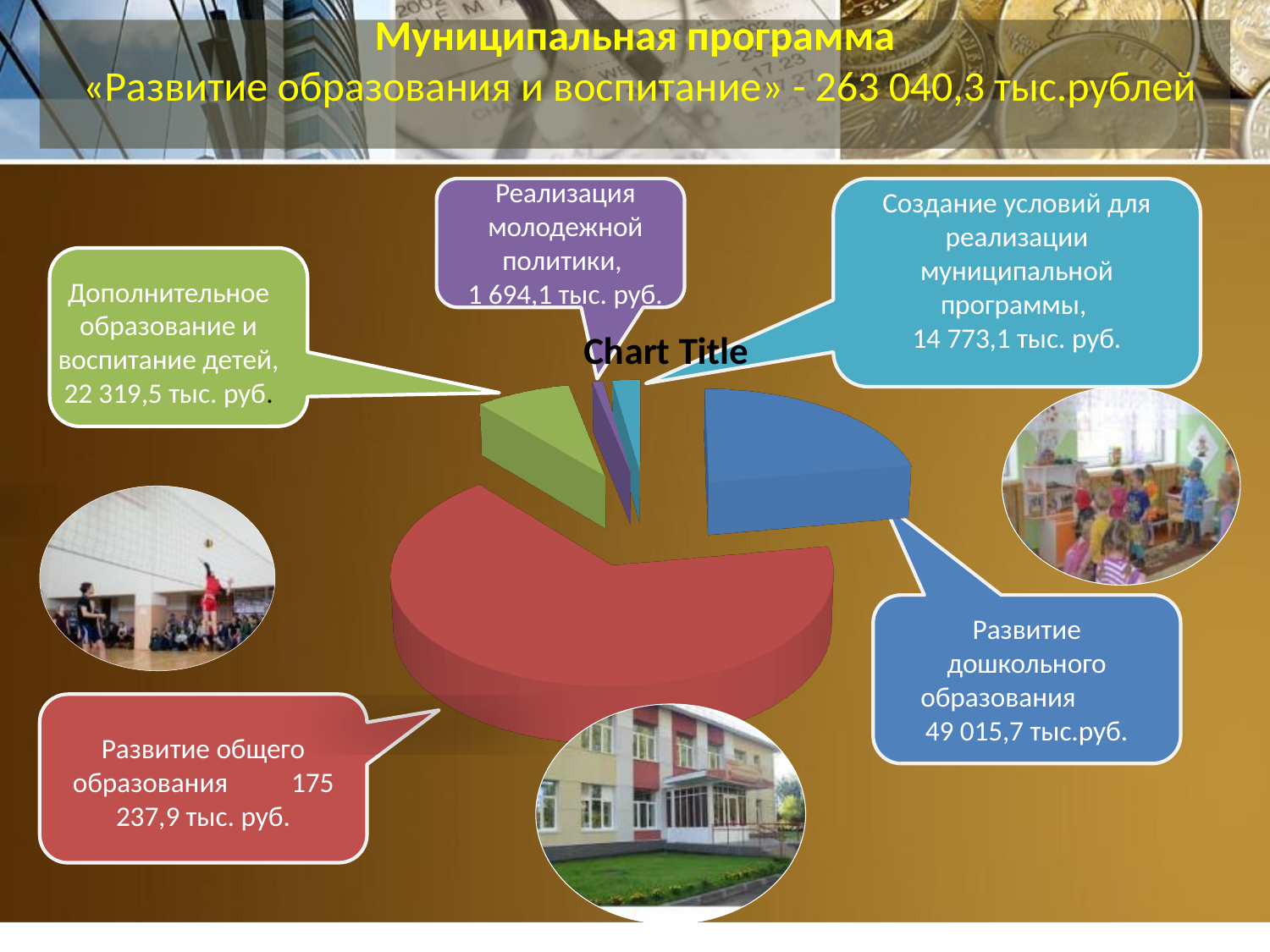
What is the value for «Реализация молодежной политики»? 1 694,1 тыс. руб. What kind of chart is shown on the slide? pie chart What is the value for «Создание условий для реализации муниципальной программы»? 14 773,1 тыс. руб. Which category has the largest slice of the pie? Развитие общего образования How many slices does the pie chart have? 5 What is the value for «Дополнительное образование и воспитание детей»? 22 319,5 тыс. руб. Which is larger: «Развитие дошкольного образования» or «Дополнительное образование и воспитание детей»? Развитие дошкольного образования What is the value for «Развитие дошкольного образования»? 49 015,7 тыс.руб. What is the difference between «Развитие дошкольного образования» and «Дополнительное образование и воспитание детей»? 26 696,2 тыс. руб. What is the value for «Развитие общего образования»? 175 237,9 тыс. руб. Which category has the smallest slice of the pie? Реализация молодежной политики What is the title printed on the chart? Chart Title